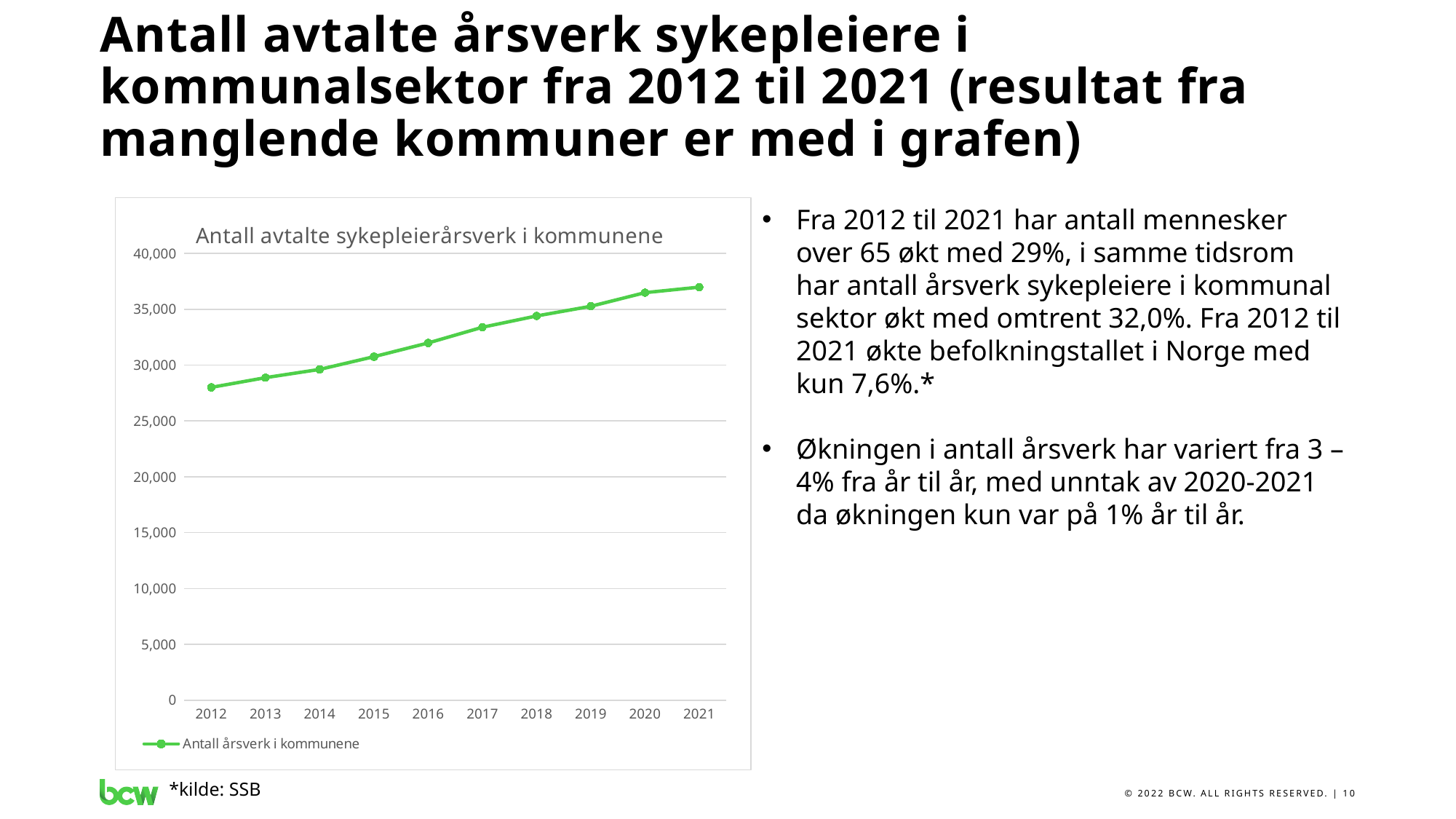
Which year has the highest value? 2021 What is the legend entry for the plotted series? Antall årsverk i kommunene How many series does the chart legend list? 1 What kind of chart is shown on the slide? line chart How many years are plotted along the x axis? 10 Is the value for 2016 greater or less than 30,000? greater Which year has the lowest value? 2012 Is the value for 2012 greater or less than 30,000? less Which is larger, the value for 2015 or the value for 2019? 2019 Is the value for 2021 greater or less than 35,000? greater Do the values rise or fall from 2012 to 2021? rise What is the title of the chart? Antall avtalte sykepleierårsverk i kommunene